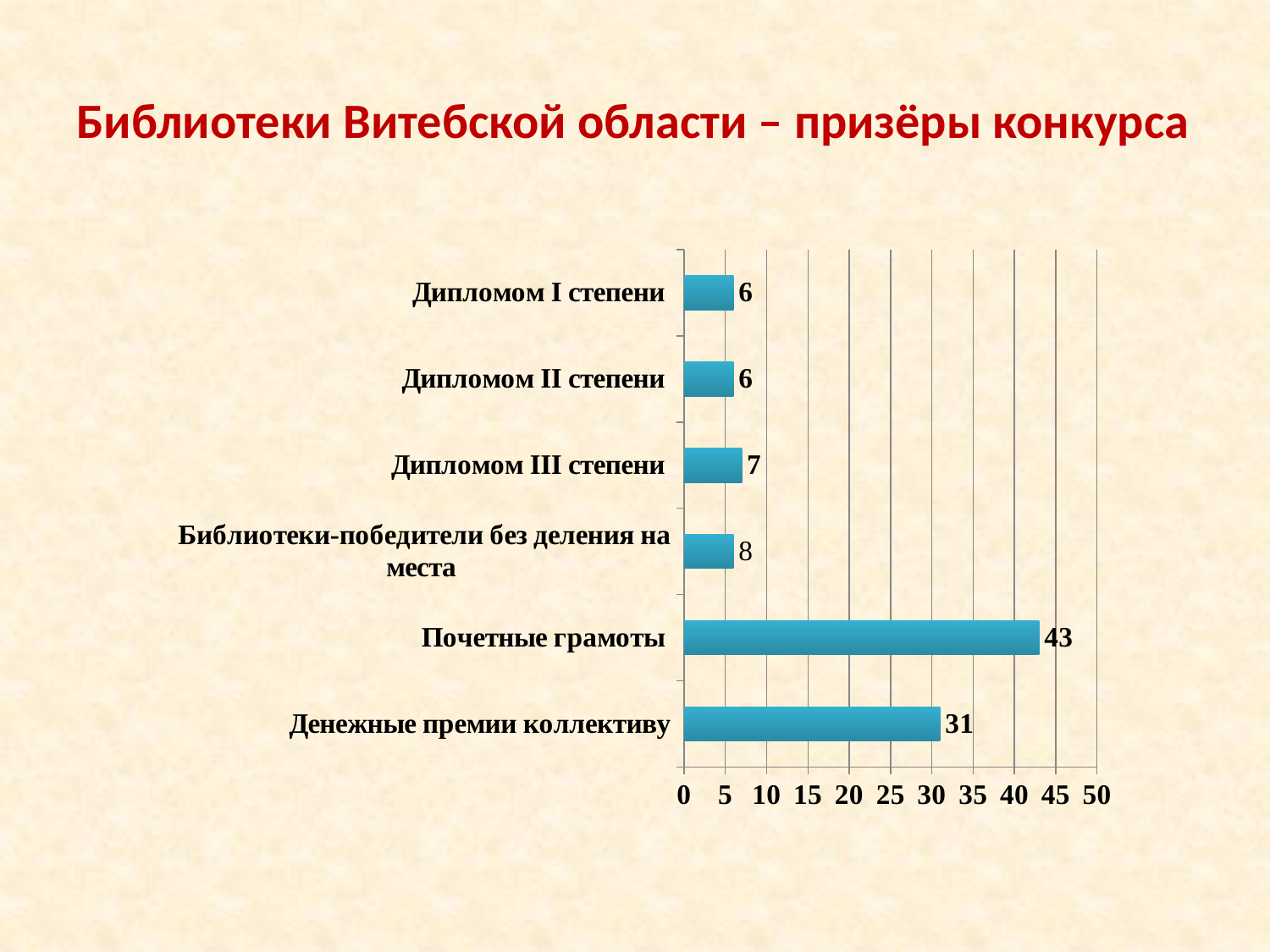
What kind of chart is shown on the slide? bar chart Which is larger, the value for Дипломом III степени or the value for Библиотеки-победители без деления на места? Библиотеки-победители без деления на места How many categories are shown in the chart? 6 What is the value for Библиотеки-победители без деления на места? 8 Which category has the highest value? Почетные грамоты What is the difference between the values for Почетные грамоты and Денежные премии коллективу? 12 Is the value for Денежные премии коллективу greater or less than 25? greater What is the difference between the values for Библиотеки-победители без деления на места and Дипломом I степени? 2 What is the value for Дипломом III степени? 7 What is the title of the slide? Библиотеки Витебской области – призёры конкурса What is the value for Денежные премии коллективу? 31 What is the value for Почетные грамоты? 43